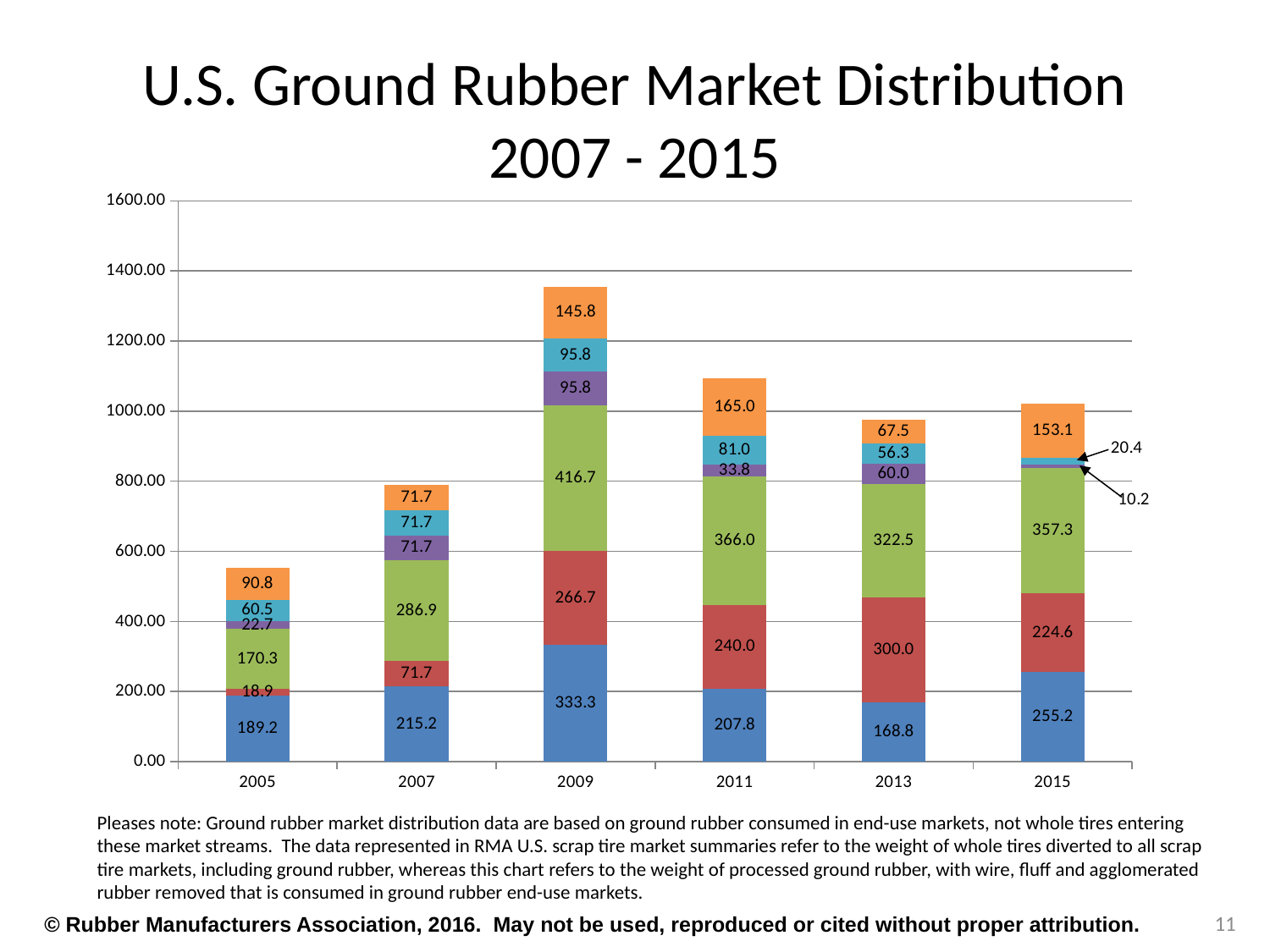
What is the total of the 2007 stacked bar? 788.9 Which year has the shortest stacked bar? 2005 What is the value of the red segment of the 2013 bar? 300.0 What is the value of the green segment of the 2015 bar? 357.3 What kind of chart is shown on the slide? Stacked bar chart How many years are shown along the x axis of the chart? 6 Is the total height of the 2013 bar greater or less than 1000.00? less What is the value of the top (orange) segment of the 2011 bar? 165.0 What is the difference between the green segment values for 2009 and 2011? 50.7 Is the bottom (blue) segment larger in 2015 or in 2013? 2015 Which year has the tallest stacked bar? 2009 What is the value of the bottom (blue) segment of the 2009 bar? 333.3